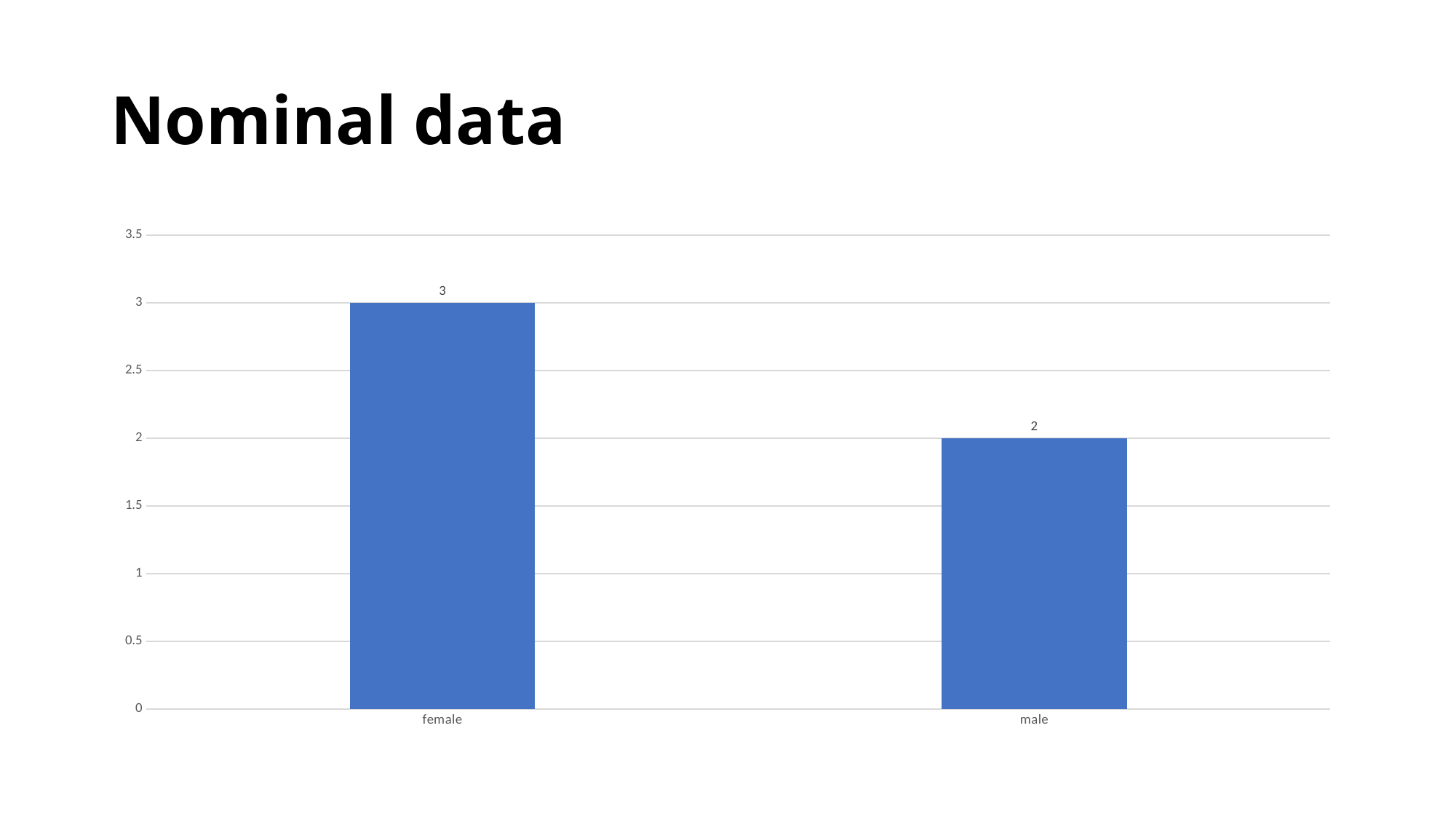
What is the difference between the values for female and male? 1 Is the value for female greater or less than 2.5? greater Which is larger, the value for female or the value for male? female Is the value for male greater or less than 2.5? less What is the title of the slide? Nominal data Which category has the highest value? female Do the values rise or fall from female to male? fall What is the value for male? 2 How many categories are shown on the x axis? 2 What is the value for female? 3 Which category has the lowest value? male What kind of chart is shown on the slide? bar chart